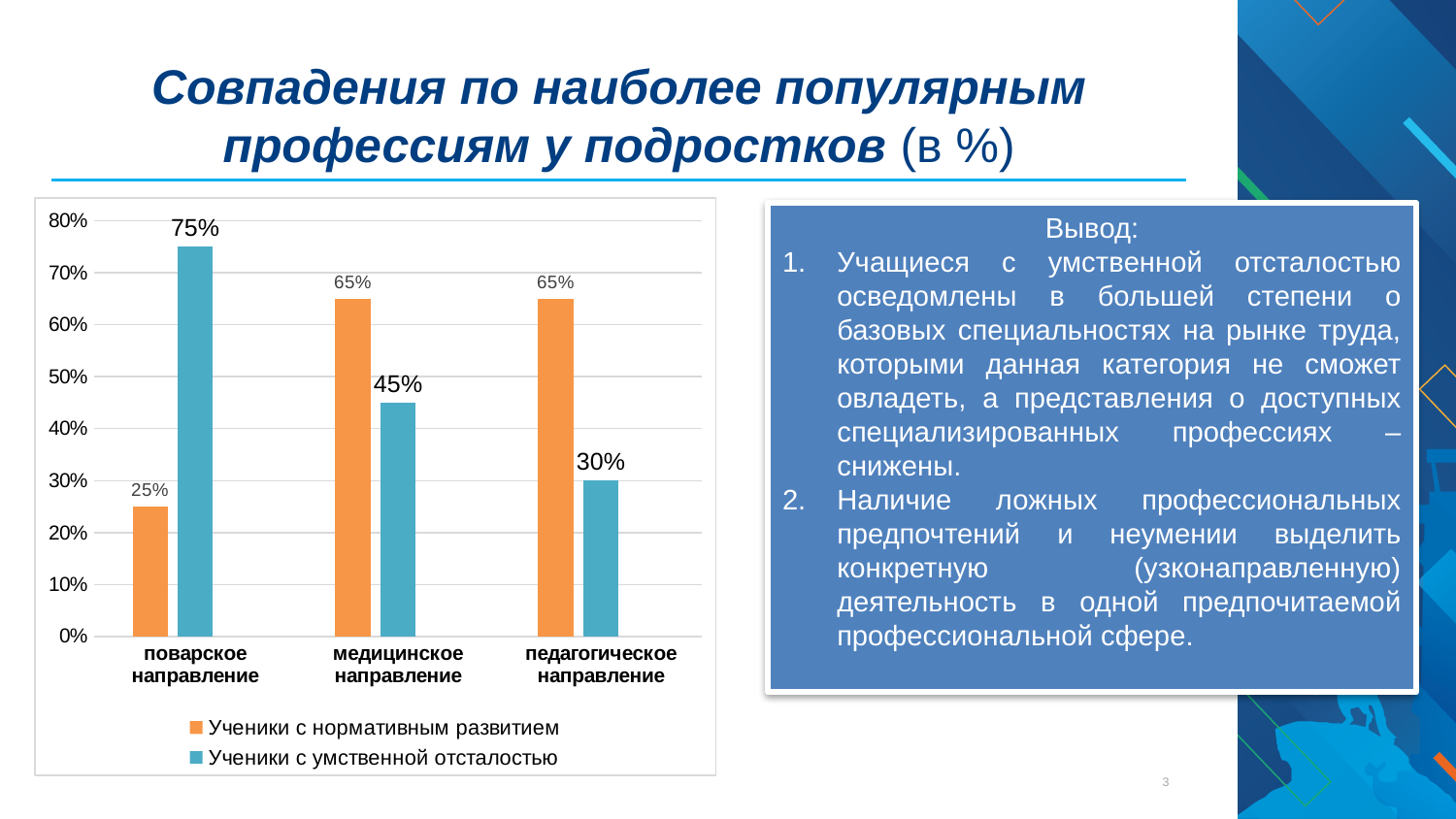
What kind of chart is shown on the slide? bar chart In which category does the 'Ученики с умственной отсталостью' series have its lowest value? педагогическое направление Does the 'Ученики с умственной отсталостью' series rise or fall across the categories from left to right? fall What is the difference between the two series in the 'поварское направление' category? 50% How many series does the legend list? 2 What is the value for 'Ученики с умственной отсталостью' in the 'поварское направление' category? 75% What is the value for 'Ученики с умственной отсталостью' in the 'медицинское направление' category? 45% In which category does the 'Ученики с умственной отсталостью' series reach its highest value? поварское направление What is the value for 'Ученики с нормативным развитием' in the 'педагогическое направление' category? 65% How many categories are shown on the x axis? 3 Which series has the larger value in the 'медицинское направление' category? Ученики с нормативным развитием What is the value for 'Ученики с нормативным развитием' in the 'поварское направление' category? 25%